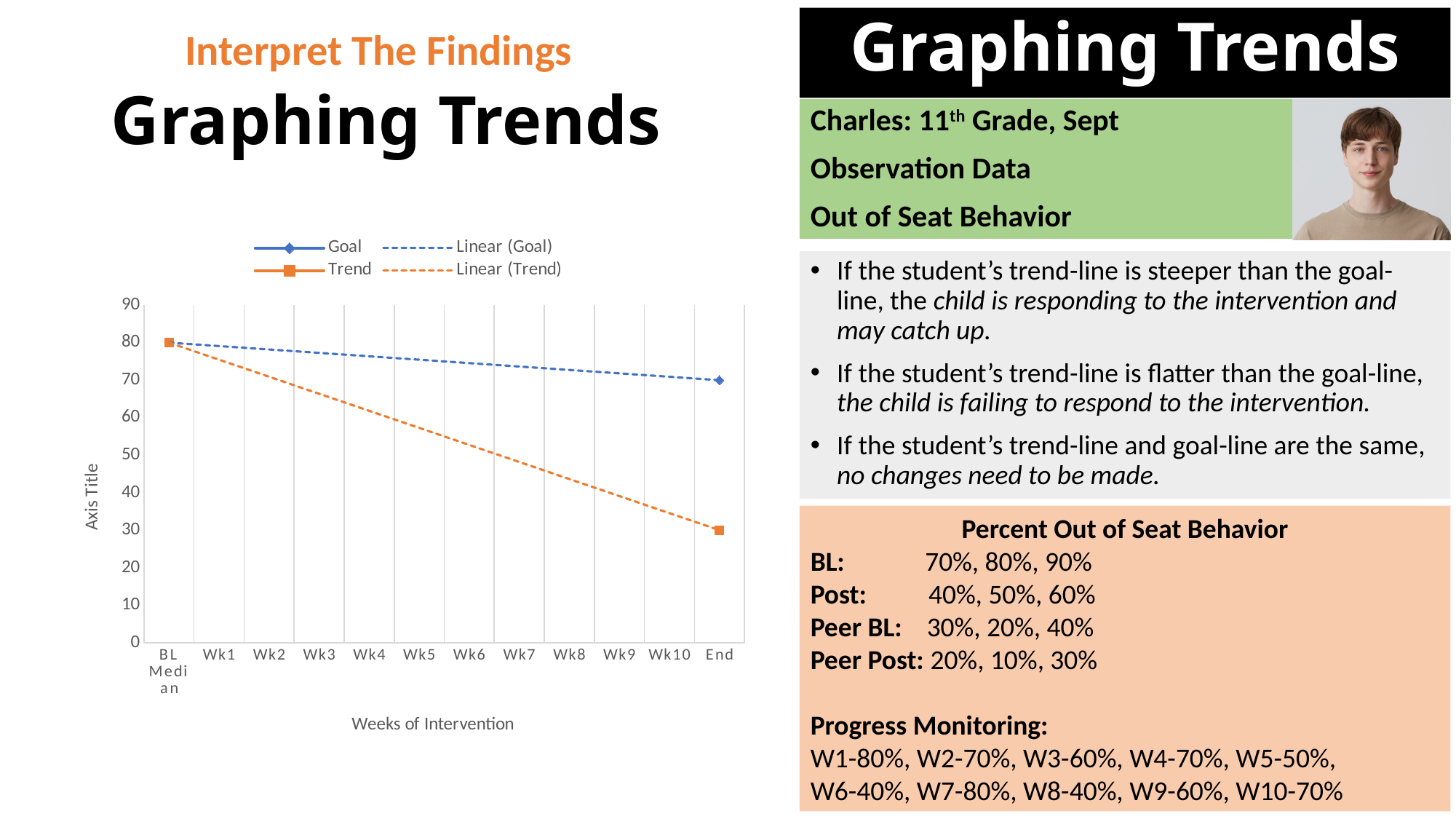
What is the title of the x axis of the chart? Weeks of Intervention Does the Trend series rise or fall from BL Median to End? fall How many entries does the chart legend list? 4 What is the value of the Trend series at End? 30 How many categories are shown along the x axis of the chart? 12 What is the value of the Goal series at End? 70 What is the value of the Trend series at BL Median? 80 What is the difference between the Goal value and the Trend value at End? 40 Is the value of the Trend series at End greater or less than 40? less At End, which series has the larger value, Goal or Trend? Goal What kind of chart is shown on the slide? line chart Is the value of the Goal series at End greater or less than 60? greater